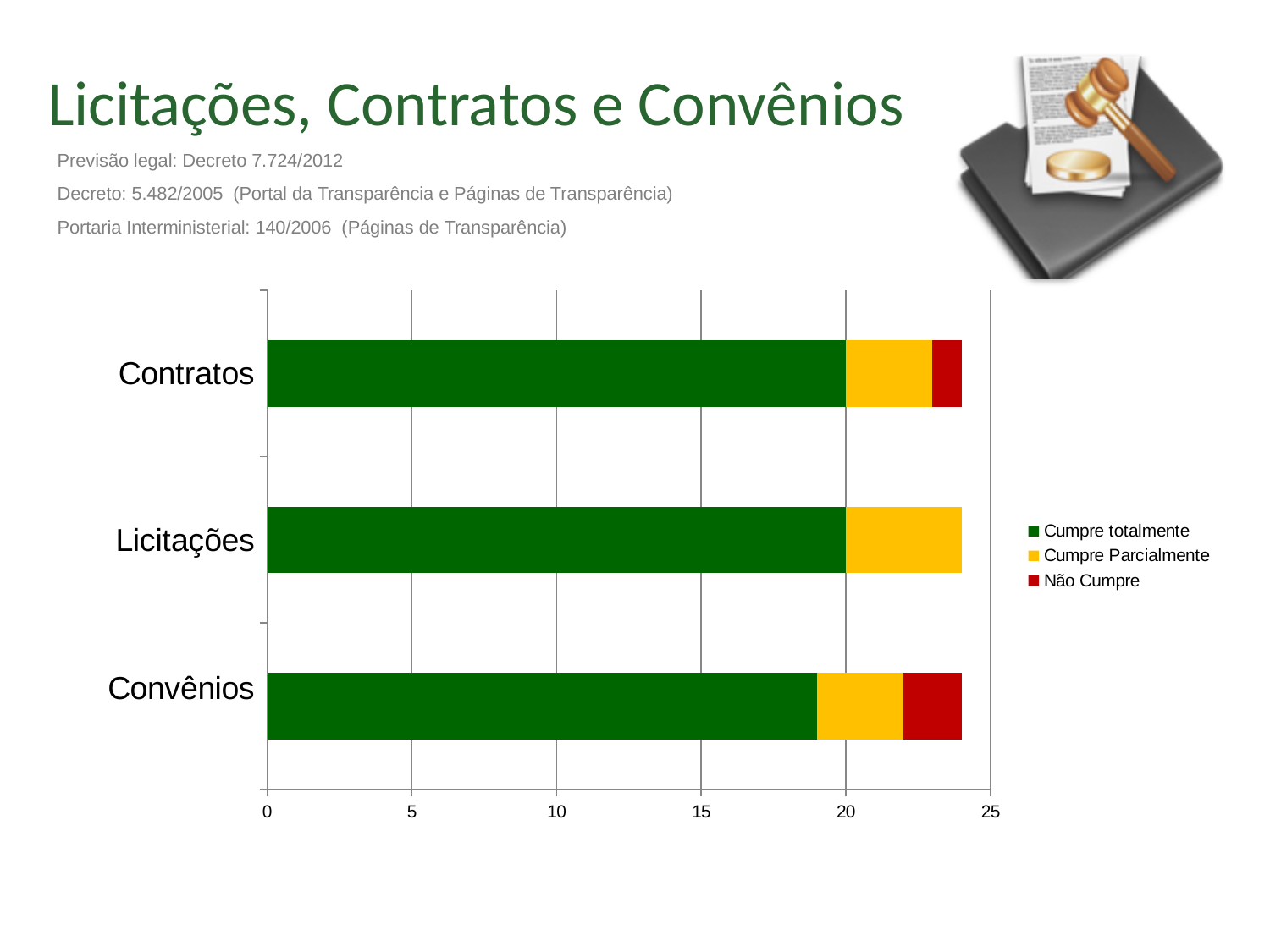
Which colour represents the Cumpre Parcialmente series? Yellow Is the Não Cumpre value for Contratos greater or less than 5? less What kind of chart is shown on the slide? Stacked bar chart How many categories are shown on the chart? 3 What is the value of Cumpre totalmente for Contratos? 20 Which category has no Não Cumpre segment in its bar? Licitações Is the Cumpre totalmente value for Convênios greater or less than 20? less Which category has the highest Não Cumpre value? Convênios What is the value of Cumpre totalmente for Licitações? 20 How many series does the chart legend list? 3 Which is larger, the Não Cumpre value for Convênios or for Contratos? Convênios Which category has the lowest Cumpre totalmente value? Convênios